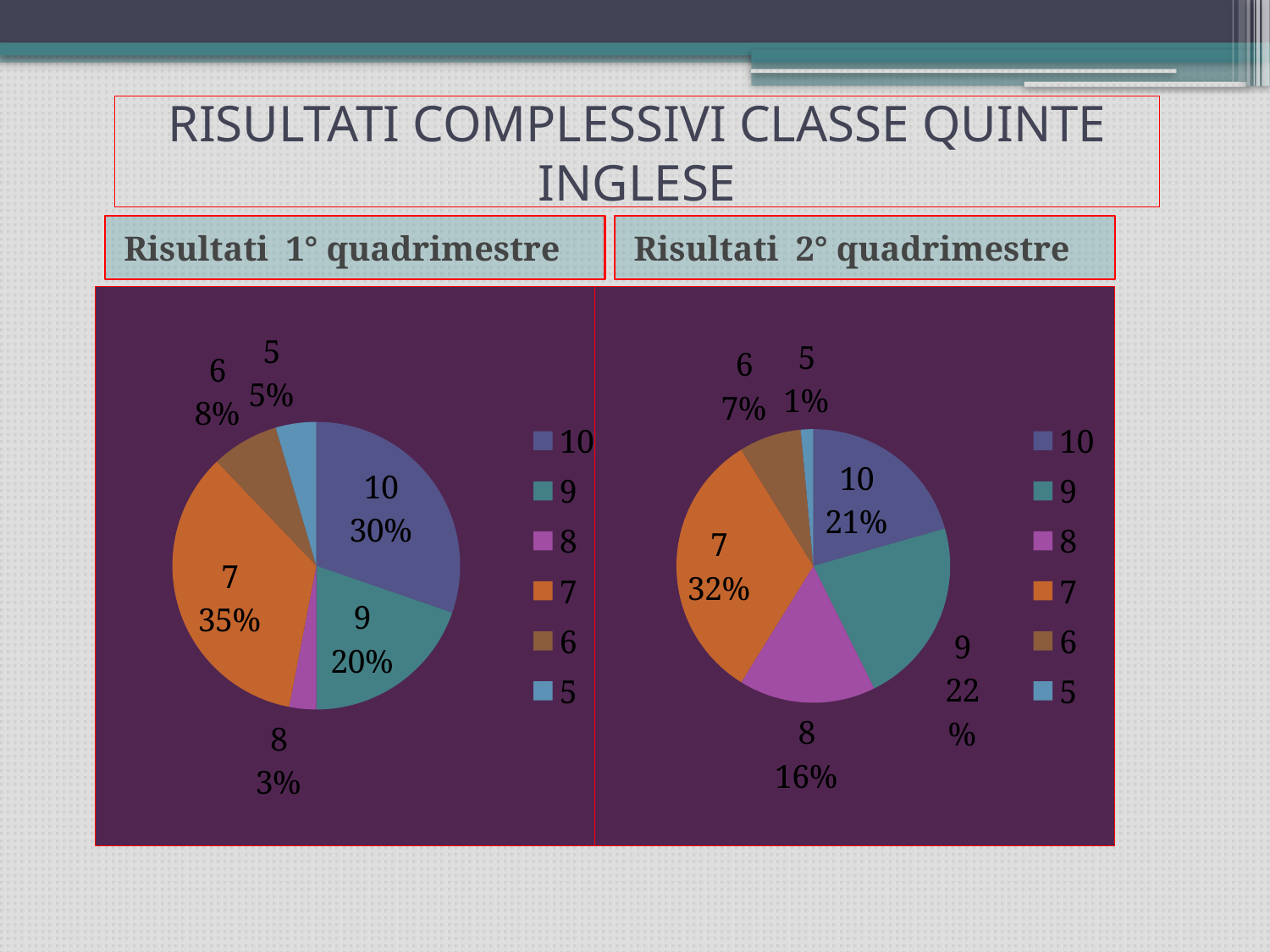
What is the title of the slide? RISULTATI COMPLESSIVI CLASSE QUINTE INGLESE In the 'Risultati 1° quadrimestre' chart, what is the difference between the percentages for grade 10 and grade 9? 10% How many entries does the legend of the 'Risultati 2° quadrimestre' chart list? 6 How many slices does the 'Risultati 1° quadrimestre' pie chart have? 6 What type of chart is used for 'Risultati 2° quadrimestre'? Pie chart In the 'Risultati 2° quadrimestre' chart, which grade has the smallest slice? 5 In the 'Risultati 1° quadrimestre' chart, what percentage is shown for grade 7? 35% In the 'Risultati 2° quadrimestre' chart, which is larger: the share for grade 9 or the share for grade 8? 9 In the 'Risultati 1° quadrimestre' chart, which grade has the largest slice? 7 In the 'Risultati 2° quadrimestre' chart, what percentage is shown for grade 5? 1% In the 'Risultati 2° quadrimestre' chart, what percentage is shown for grade 10? 21% In the 'Risultati 1° quadrimestre' chart, what percentage is shown for grade 8? 3%